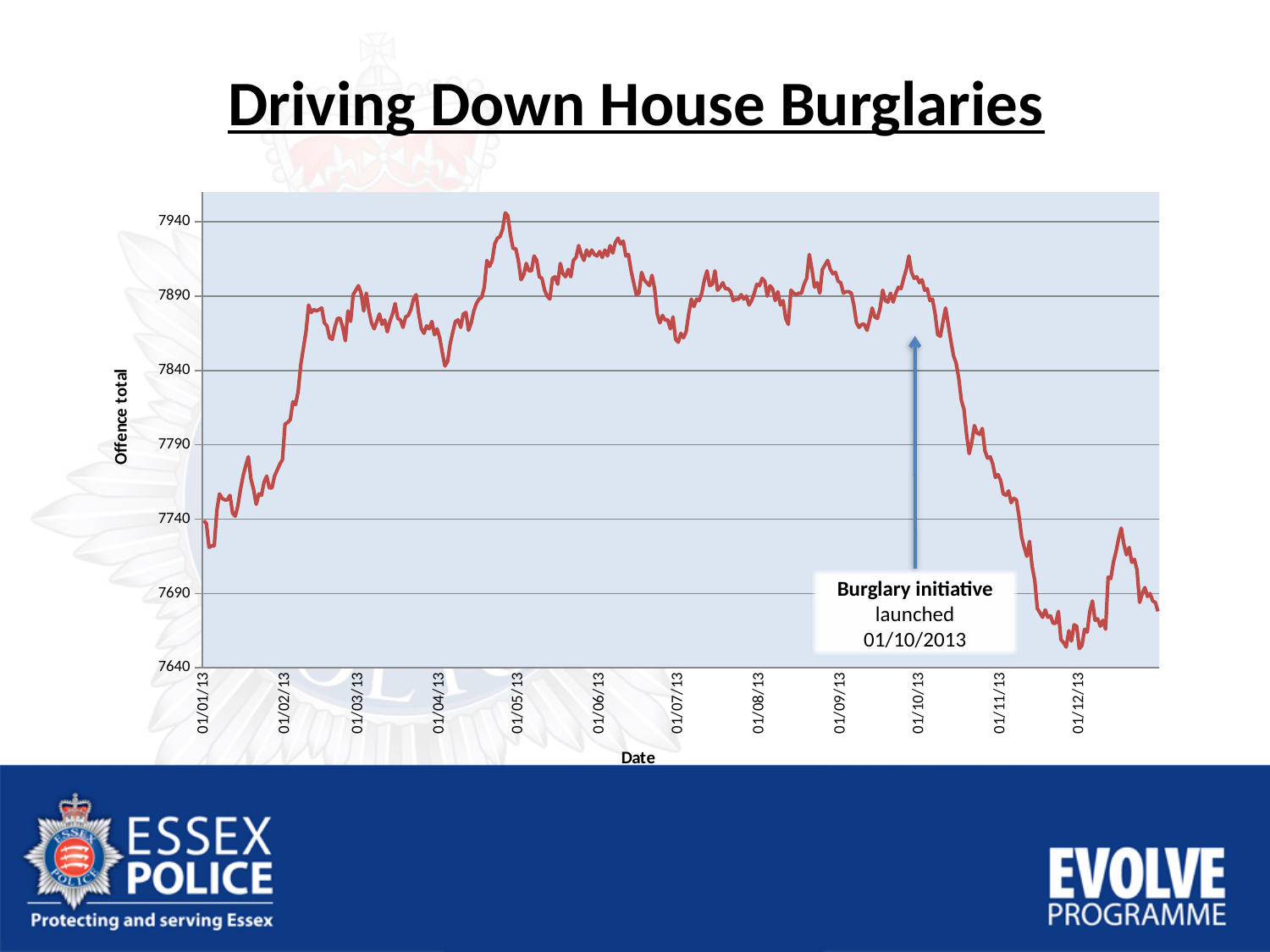
What kind of chart is shown on the slide? line chart Is the offence total at 01/05/13 greater or less than 7890? greater Is the offence total at 01/11/13 greater or less than 7840? less Is the offence total at 01/12/13 greater or less than 7740? less What is the title of the slide's chart? Driving Down House Burglaries How many date labels are shown on the x axis? 12 What is the label on the vertical axis of the chart? Offence total Which is larger, the offence total at 01/05/13 or at 01/12/13? 01/05/13 Does the offence total rise or fall between 01/01/13 and 01/02/13? rise Does the offence total rise or fall between 01/10/13 and 01/12/13? fall